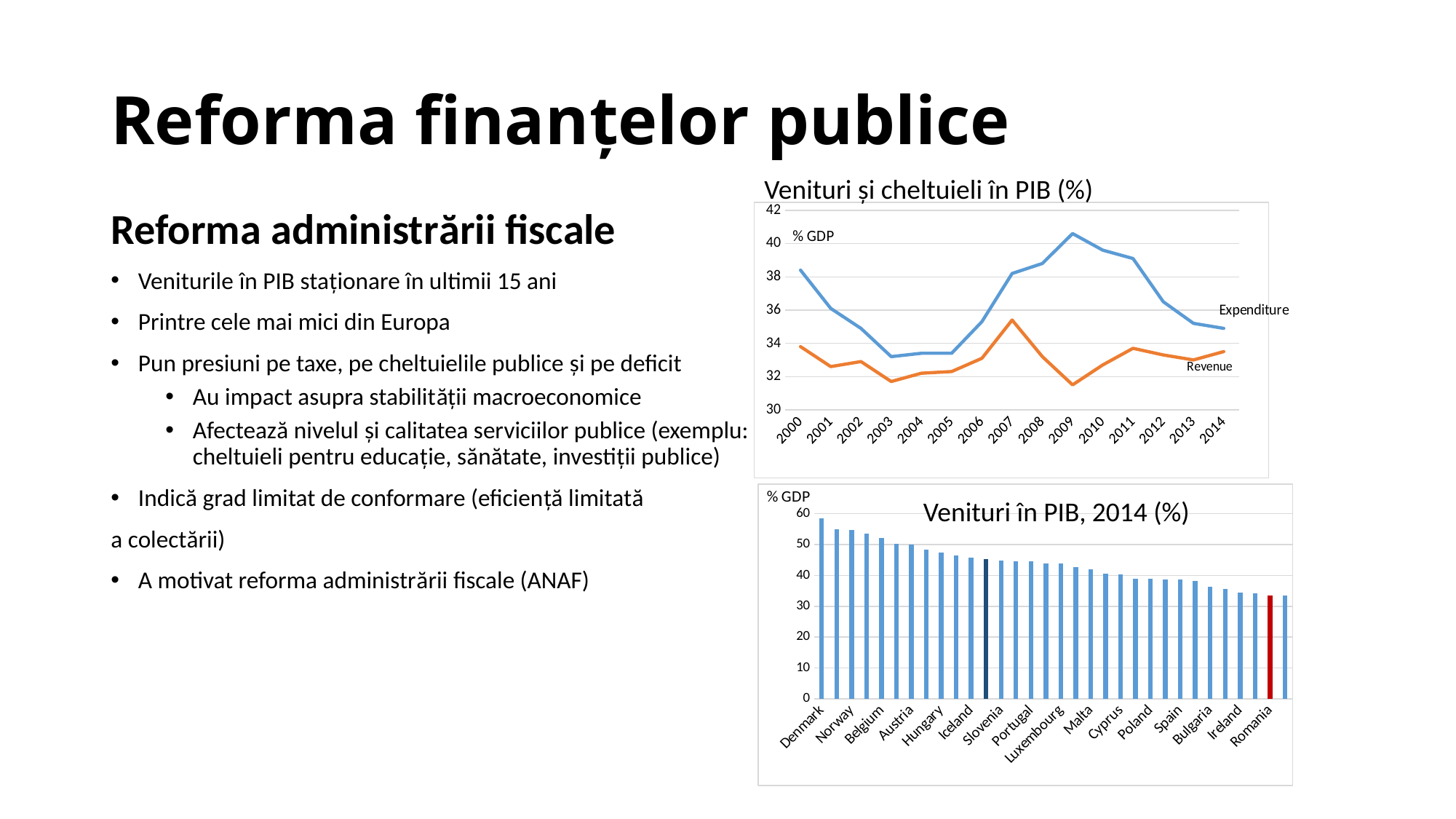
What type of chart is the chart titled 'Venituri în PIB, 2014 (%)'? bar chart In the chart 'Venituri și cheltuieli în PIB (%)', is the Revenue value for 2009 greater or less than 32? less In the chart 'Venituri și cheltuieli în PIB (%)', in which year does Revenue reach its highest value? 2007 In the chart 'Venituri în PIB, 2014 (%)', do the values rise or fall from left to right? fall In the chart 'Venituri în PIB, 2014 (%)', which country has the highest value? Denmark In the chart 'Venituri și cheltuieli în PIB (%)', how many series are plotted? 2 What type of chart is the chart titled 'Venituri și cheltuieli în PIB (%)'? line chart In the chart 'Venituri și cheltuieli în PIB (%)', in which year does Expenditure reach its highest value? 2009 In the chart 'Venituri și cheltuieli în PIB (%)', which series is higher in 2009, Expenditure or Revenue? Expenditure In the chart 'Venituri și cheltuieli în PIB (%)', how many years are shown on the x axis? 15 In the chart 'Venituri în PIB, 2014 (%)', is the value for Romania greater or less than 40? less In the chart 'Venituri și cheltuieli în PIB (%)', is the Expenditure value for 2009 greater or less than 40? greater